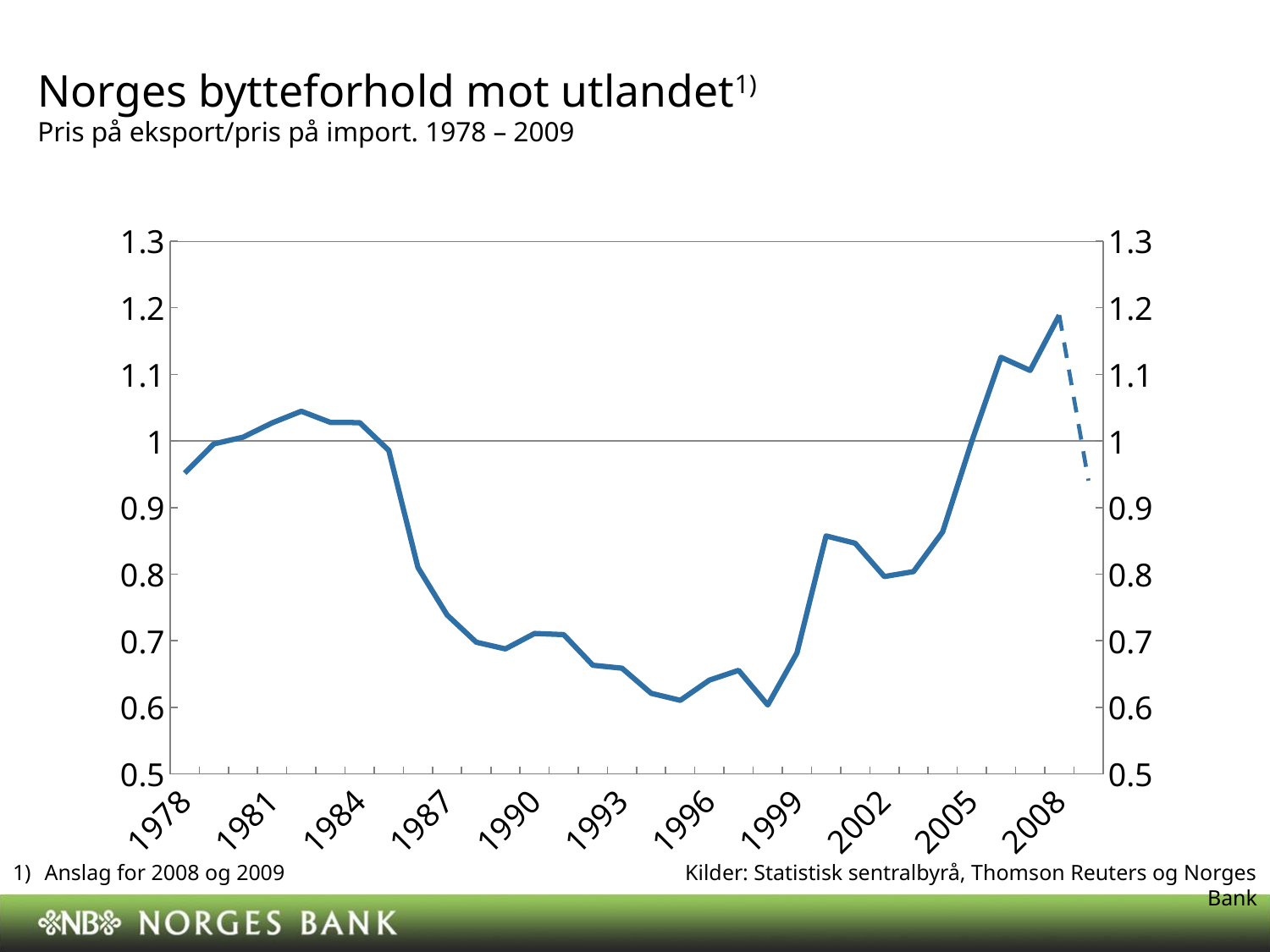
What kind of chart is shown on the slide? Line chart What is the title of the chart? Norges bytteforhold mot utlandet Is the value for 1984 greater or less than 1? greater Is the value for 2008 greater or less than 1.1? greater Is the value for 1993 greater or less than 0.7? less Does the line rise or fall between 1985 and 1987? Fall Which years are marked as estimates (anslag) in the footnote? 2008 og 2009 Does the line rise or fall between 2008 and 2009? Fall In which year does the line reach its highest value? 2008